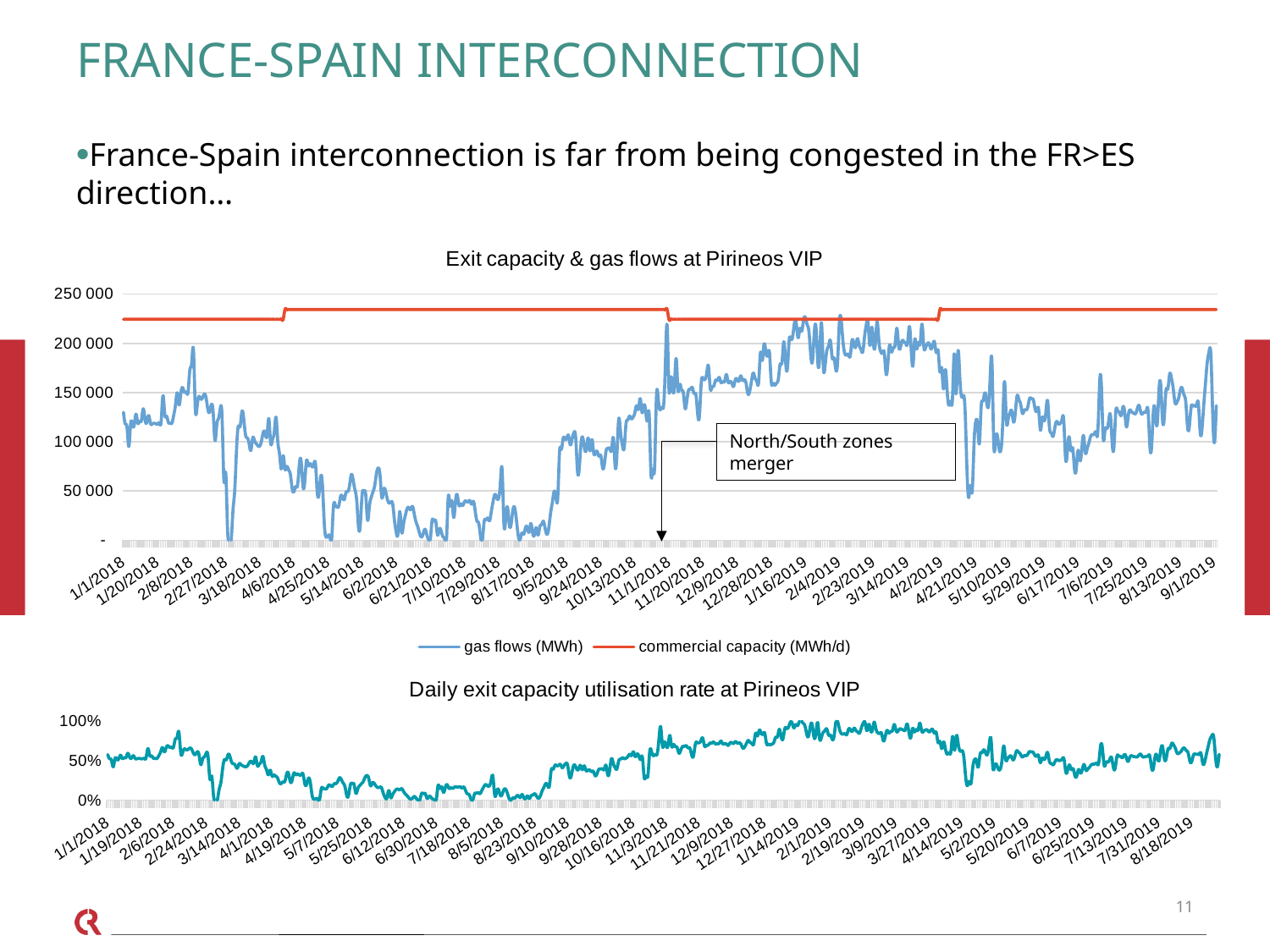
In the top chart "Exit capacity & gas flows at Pirineos VIP", do the gas flows (MWh) rise or fall between 9/5/2018 and 1/16/2019? rise What event does the annotation on the top chart "Exit capacity & gas flows at Pirineos VIP" mark? North/South zones merger In the bottom chart "Daily exit capacity utilisation rate at Pirineos VIP", is the utilisation rate around 2/1/2019 greater or less than 50%? greater What kind of chart is the top chart titled "Exit capacity & gas flows at Pirineos VIP"? Line chart In the top chart "Exit capacity & gas flows at Pirineos VIP", which series is drawn in red? commercial capacity (MWh/d) In the top chart "Exit capacity & gas flows at Pirineos VIP", which series is higher around 7/10/2018: gas flows (MWh) or commercial capacity (MWh/d)? commercial capacity (MWh/d) In the top chart "Exit capacity & gas flows at Pirineos VIP", is the commercial capacity (MWh/d) greater or less than 200 000 throughout the period? greater In the bottom chart "Daily exit capacity utilisation rate at Pirineos VIP", is the utilisation rate around 6/12/2018 greater or less than 50%? less How many series does the legend of the top chart "Exit capacity & gas flows at Pirineos VIP" list? 2 What kind of chart is the bottom chart titled "Daily exit capacity utilisation rate at Pirineos VIP"? Line chart